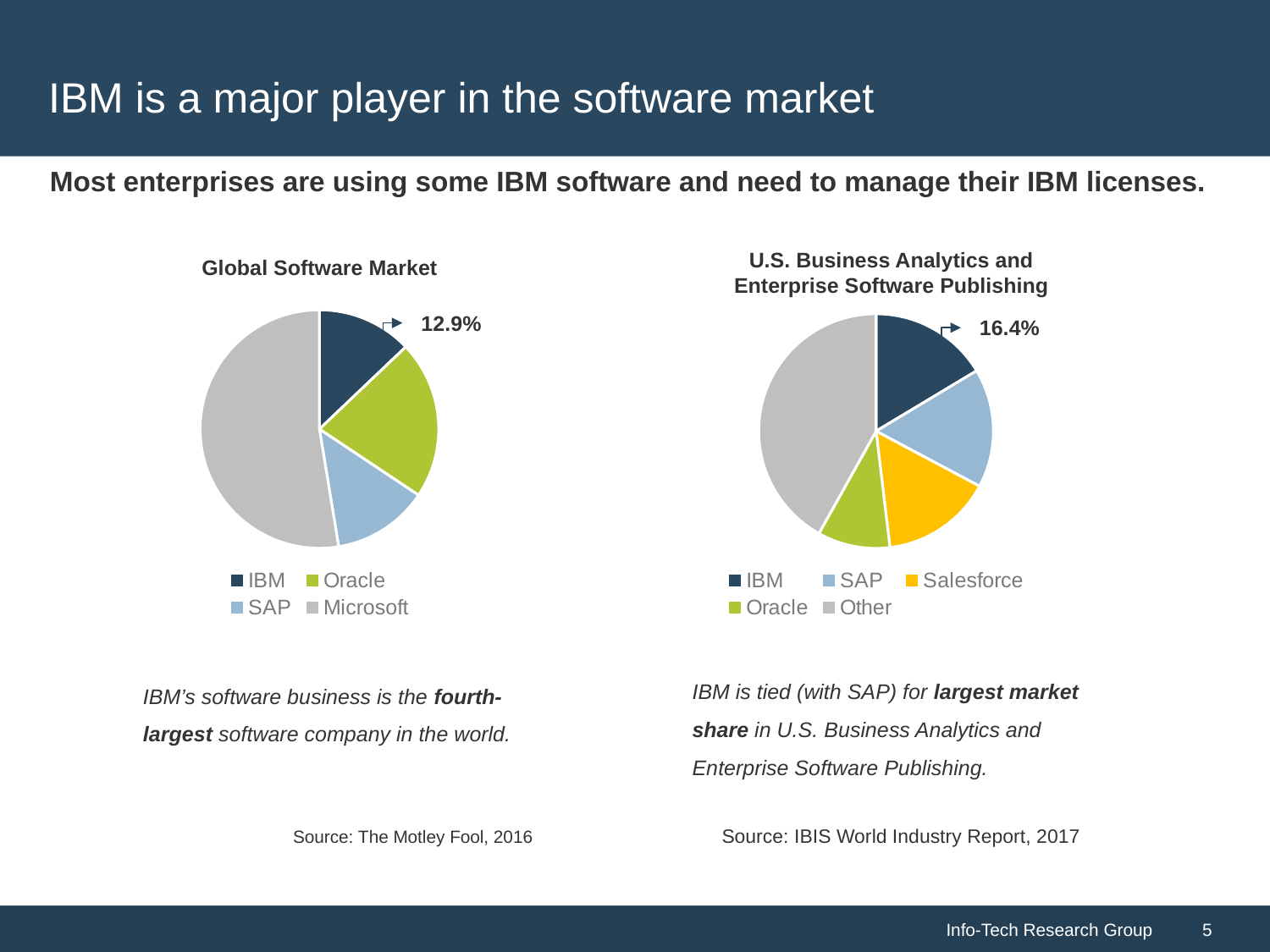
In the Global Software Market chart, which category has the largest slice? Microsoft In the Global Software Market chart, what share is labelled for IBM? 12.9% What kind of chart is the U.S. Business Analytics and Enterprise Software Publishing chart? Pie chart In the U.S. Business Analytics and Enterprise Software Publishing chart, which category has the smallest slice? Oracle In the U.S. Business Analytics and Enterprise Software Publishing chart, which slice is larger, Salesforce or Oracle? Salesforce In the Global Software Market chart, which slice is larger, Oracle or SAP? Oracle What kind of chart is the Global Software Market chart? Pie chart How many categories does the legend of the U.S. Business Analytics and Enterprise Software Publishing chart list? 5 In the U.S. Business Analytics and Enterprise Software Publishing chart, which category has the largest slice? Other Which category appears in the legend of the U.S. Business Analytics and Enterprise Software Publishing chart but not in the Global Software Market chart's legend, besides Other? Salesforce In the U.S. Business Analytics and Enterprise Software Publishing chart, what share is labelled for IBM? 16.4% How many categories does the legend of the Global Software Market chart list? 4